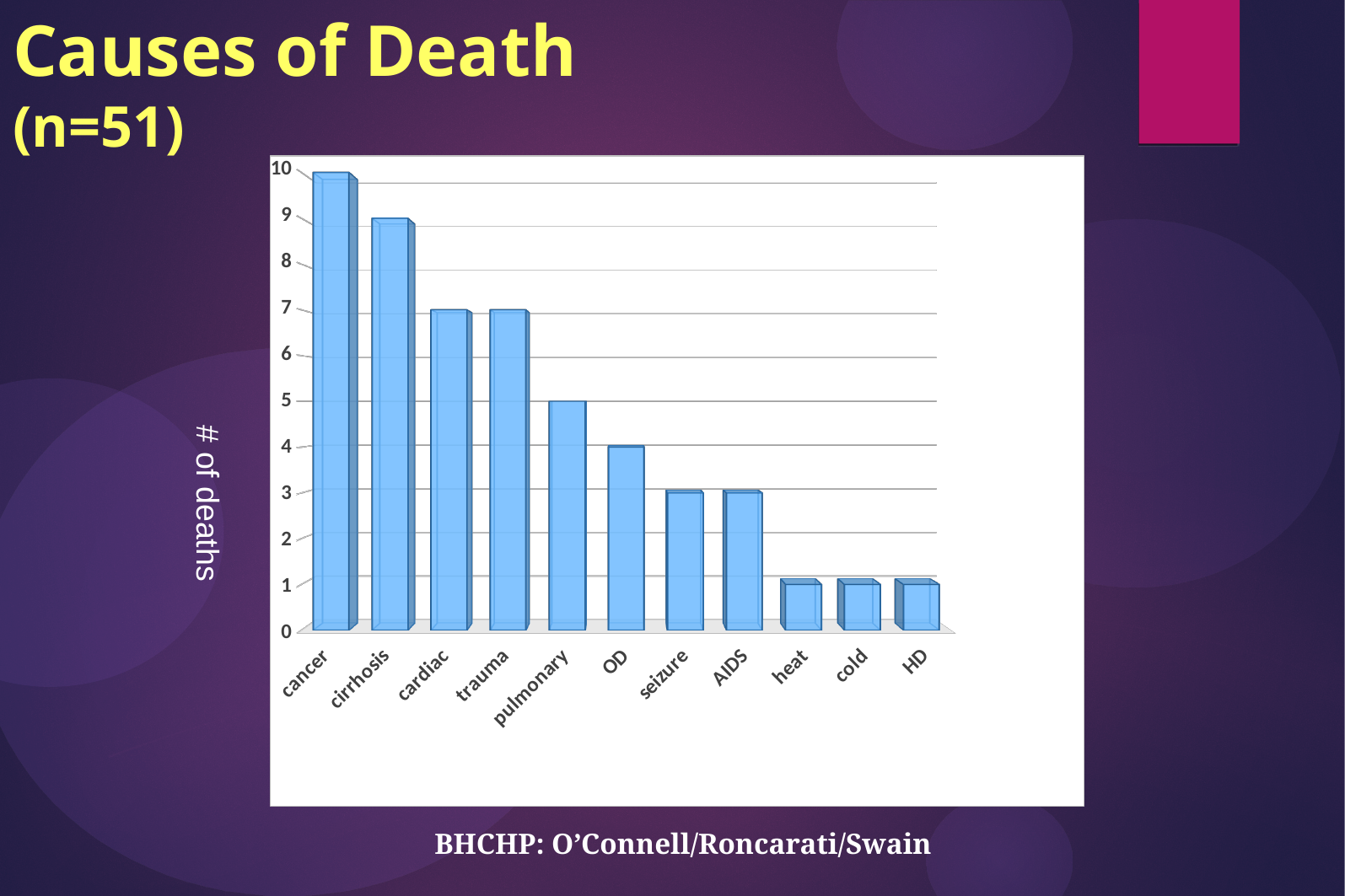
How many causes of death are shown on the x axis? 11 What is the label on the vertical axis of the chart? # of deaths How many deaths are attributed to pulmonary causes? 5 Which has more deaths, trauma or seizure? trauma Is the number of deaths from cardiac causes greater or less than 5? greater What is the difference in number of deaths between cancer and cirrhosis? 1 How many deaths are attributed to OD? 4 Do the bar values rise or fall from left to right along the x axis? fall How many deaths are attributed to cancer? 10 How many deaths are attributed to cirrhosis? 9 What kind of chart is shown on the slide? bar chart Which cause of death has the highest number of deaths? cancer